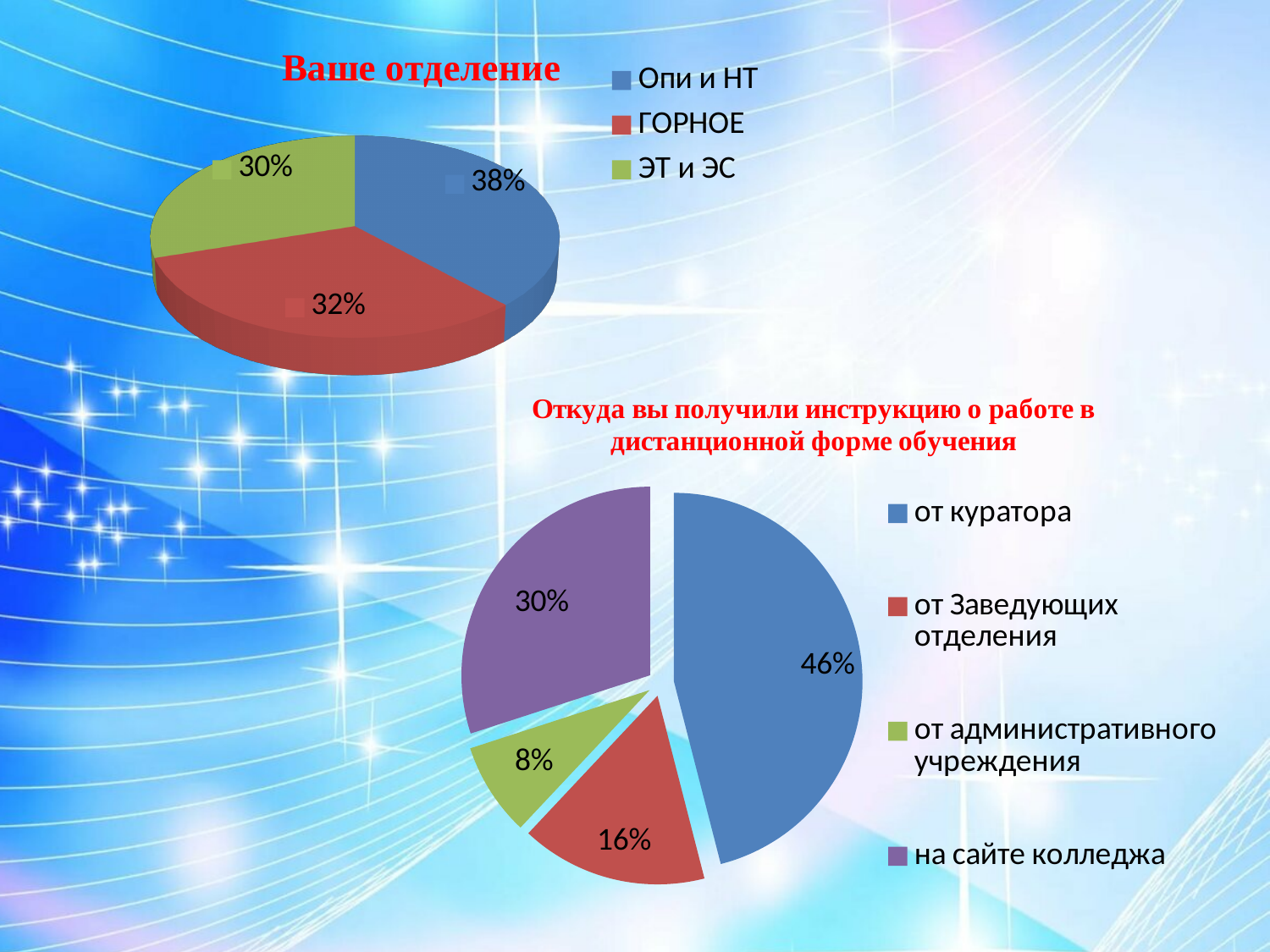
In the chart titled "Ваше отделение", what share is shown for ГОРНОЕ? 32% In the chart titled "Ваше отделение", what share is shown for Опи и НТ? 38% In the bottom chart ("Откуда вы получили инструкцию о работе в дистанционной форме обучения"), how many categories does the legend list? 4 In the chart titled "Ваше отделение", which category has the smallest slice? ЭТ и ЭС In the chart titled "Ваше отделение", which category has the largest slice? Опи и НТ What type of chart is the bottom chart on the slide? Pie chart In the bottom chart ("Откуда вы получили инструкцию о работе в дистанционной форме обучения"), which is larger: "от Заведующих отделения" or "на сайте колледжа"? на сайте колледжа In the bottom chart ("Откуда вы получили инструкцию о работе в дистанционной форме обучения"), which category has the smallest slice? от административного учреждения In the chart titled "Ваше отделение", what is the difference in percentage points between Опи и НТ and ЭТ и ЭС? 8 In the bottom chart ("Откуда вы получили инструкцию о работе в дистанционной форме обучения"), what share is shown for "на сайте колледжа"? 30% In the bottom chart ("Откуда вы получили инструкцию о работе в дистанционной форме обучения"), what share is shown for "от куратора"? 46% In the chart titled "Ваше отделение", how many categories does the legend list? 3